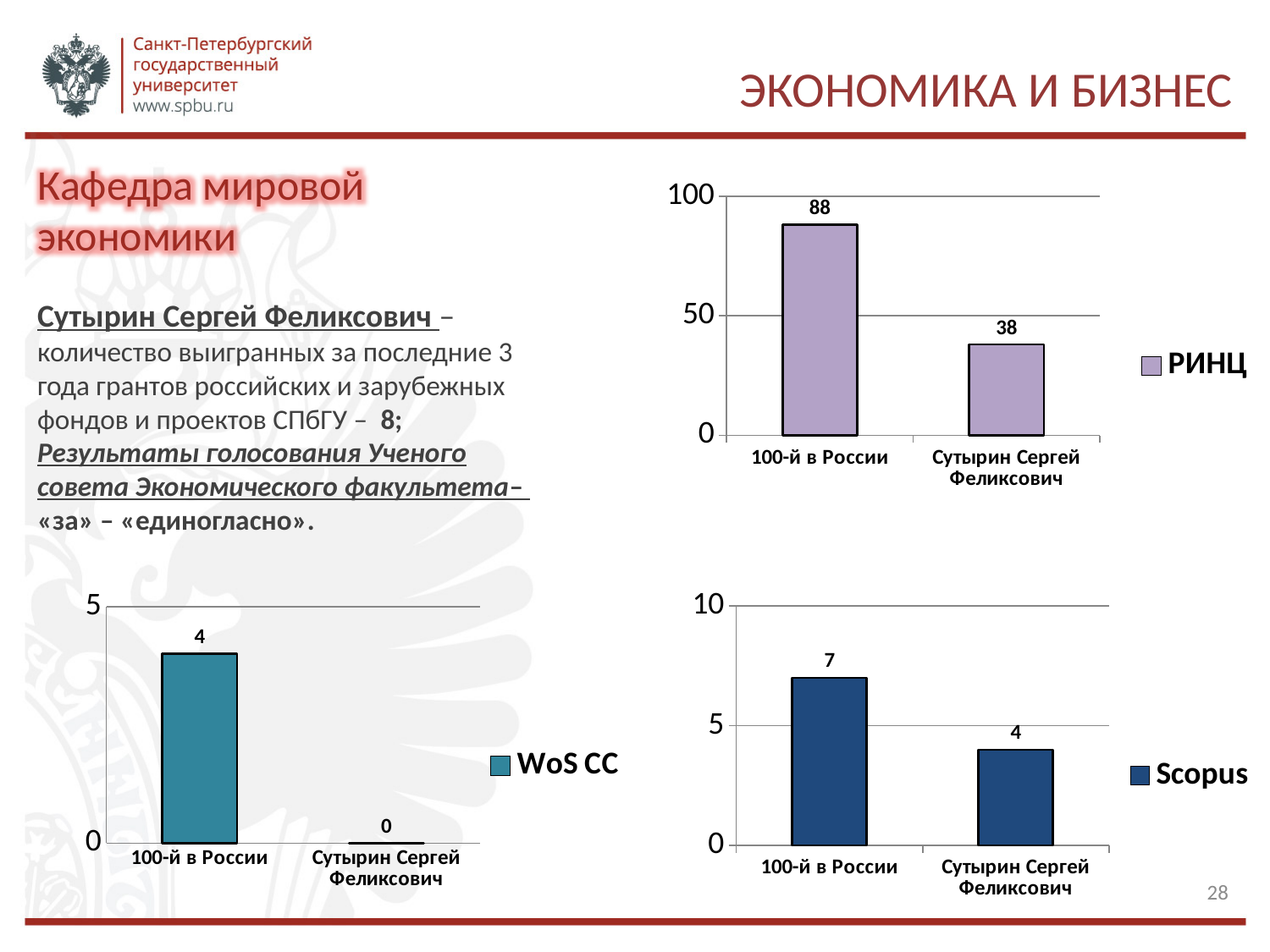
What kind of chart is the Scopus chart (bottom right)? bar chart In the Scopus chart (bottom right), what is the value for 100-й в России? 7 In the Scopus chart (bottom right), what is the value for Сутырин Сергей Феликсович? 4 How many categories are shown in the WoS CC chart (bottom left)? 2 In the Scopus chart (bottom right), what is the difference between the values for 100-й в России and Сутырин Сергей Феликсович? 3 In the WoS CC chart (bottom left), what is the value for 100-й в России? 4 In the WoS CC chart (bottom left), what is the value for Сутырин Сергей Феликсович? 0 In the РИНЦ chart (top right), is the value for Сутырин Сергей Феликсович greater or less than 50? less In the РИНЦ chart (top right), what is the difference between the values for 100-й в России and Сутырин Сергей Феликсович? 50 In the РИНЦ chart (top right), what is the value for 100-й в России? 88 In the Scopus chart (bottom right), which category has the higher value? 100-й в России In the РИНЦ chart (top right), what is the value for Сутырин Сергей Феликсович? 38